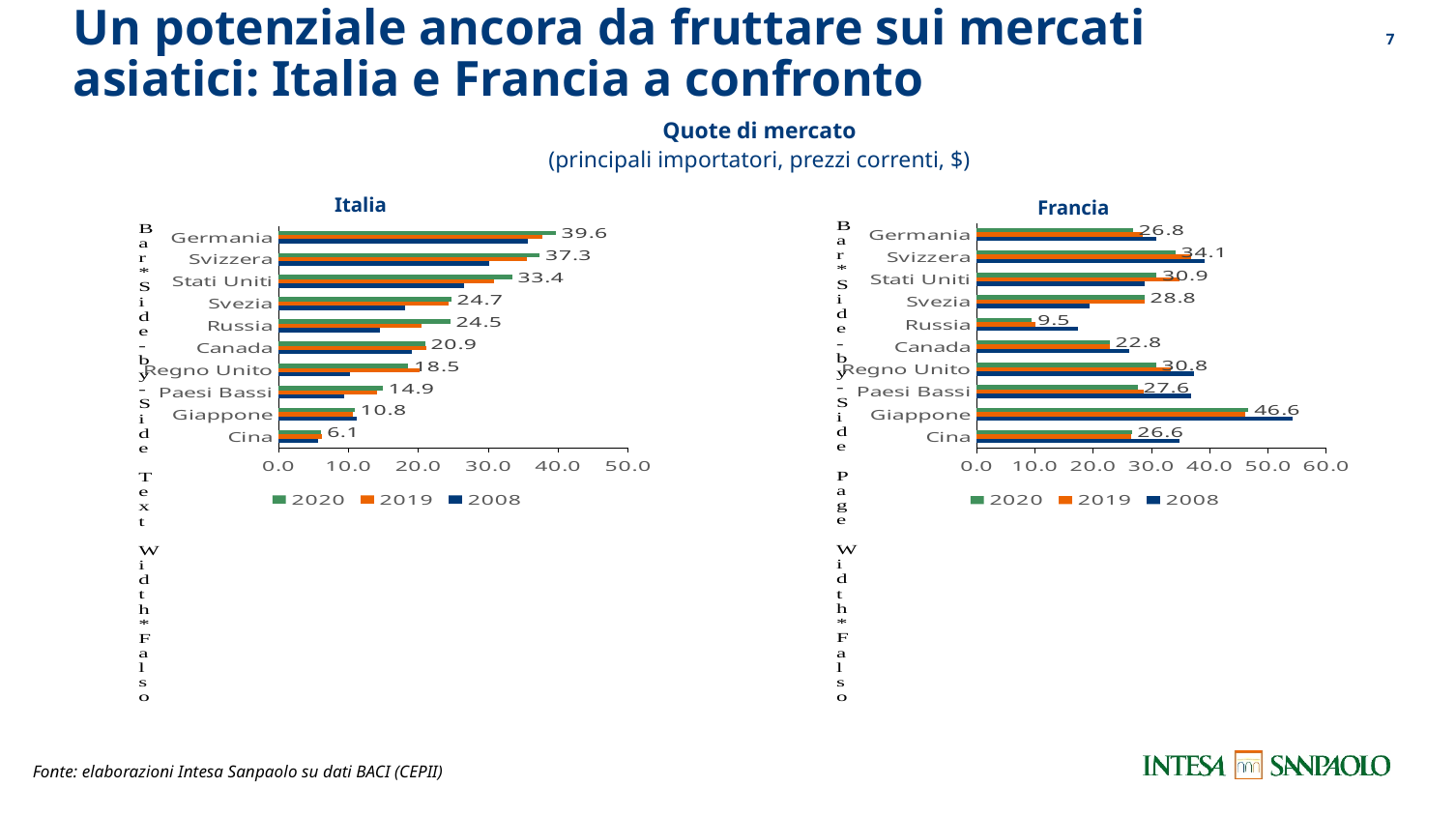
Which years are listed in the legend of the Italia chart? 2020, 2019, 2008 In the Italia chart, what is the 2020 value for Germania? 39.6 In the Italia chart, is the 2008 value for Cina greater or less than 10.0? less In the Francia chart, is the 2008 value for Giappone greater or less than 50.0? greater In the Francia chart, what is the 2020 value for Giappone? 46.6 In the Francia chart, which category has the lowest 2020 value? Russia In the Italia chart, which category has the highest 2020 value? Germania In the Francia chart, which is larger in 2020: Svizzera or Germania? Svizzera What kind of chart is the Italia chart? Bar chart In the Italia chart, what is the difference between the 2020 values for Svizzera and Stati Uniti? 3.9 How many categories are shown in the Italia chart? 10 How many series does the legend of the Francia chart list? 3